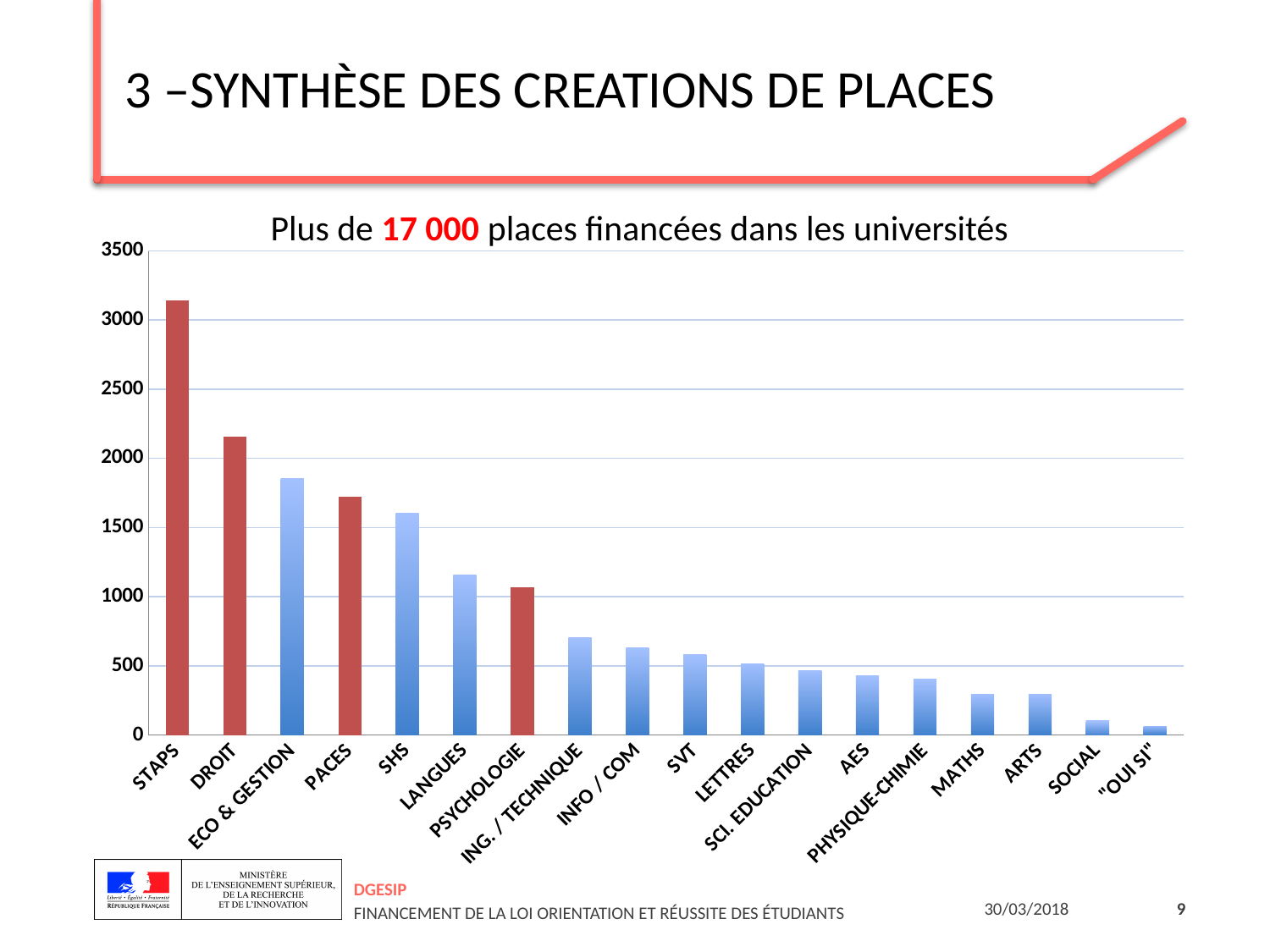
Which category has the lowest number of places created? "OUI SI" Do the bar values rise or fall from left to right along the x axis? fall Which category has the highest number of places created? STAPS What is the title of the chart? Plus de 17 000 places financées dans les universités Is the value for STAPS greater or less than 3000? greater Is the value for PSYCHOLOGIE greater or less than 1000? greater Which has a higher value, ECO & GESTION or PACES? ECO & GESTION Is the value for ING. / TECHNIQUE greater or less than 1000? less How many categories are shown on the x axis of the chart? 18 What type of chart is shown on the slide? bar chart